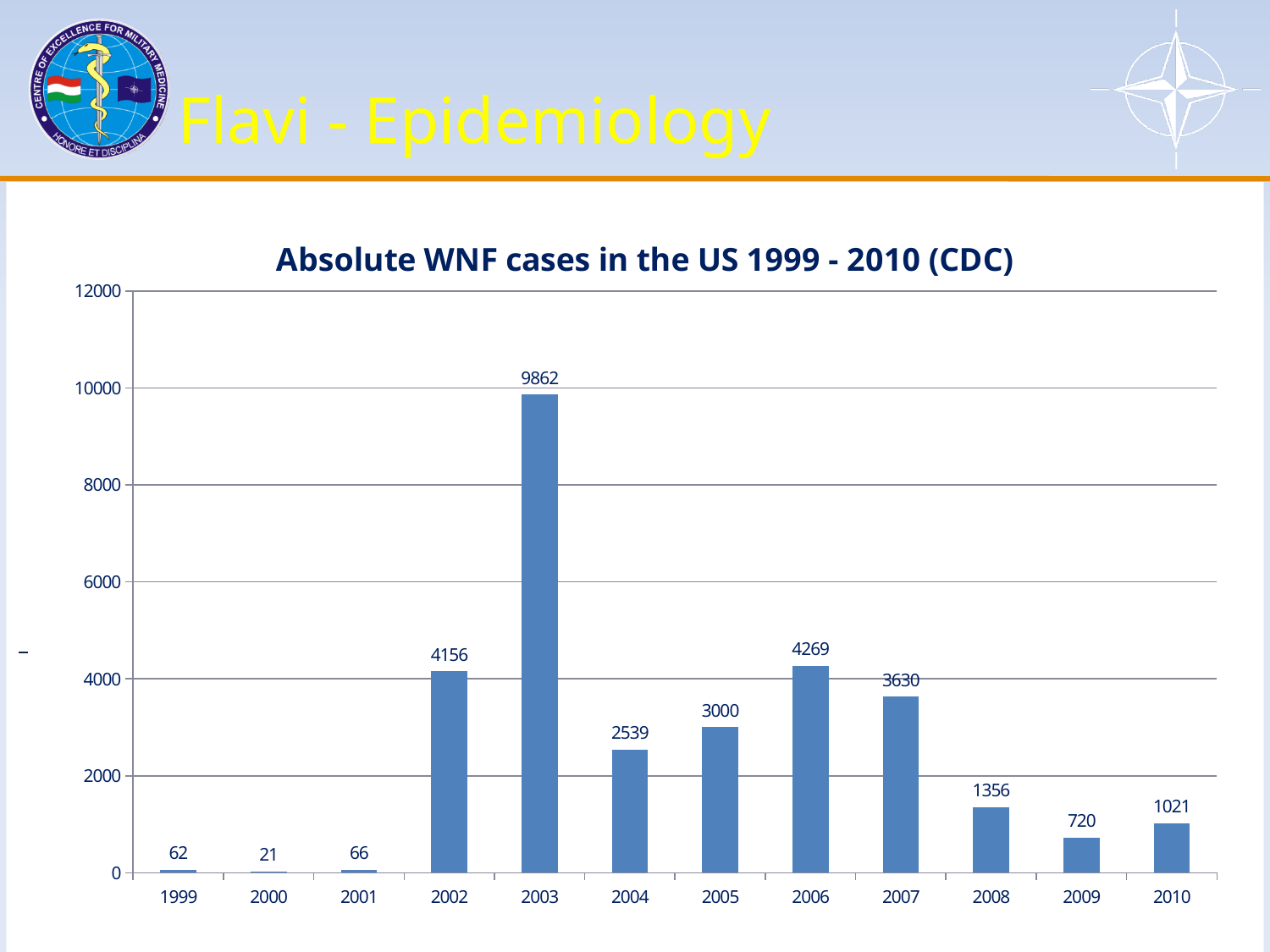
What kind of chart is shown on the slide? Bar chart Which year has the highest number of WNF cases? 2003 What is the difference in WNF cases between 2006 and 2005? 1269 What is the title of the chart? Absolute WNF cases in the US 1999 - 2010 (CDC) What is the number of WNF cases in 2000? 21 Is the value for 2008 greater or less than 2000? less What is the number of WNF cases in 2003? 9862 What is the difference in WNF cases between 2003 and 2002? 5706 Which year had more WNF cases, 2004 or 2007? 2007 How many years are shown on the x axis? 12 Which year has the lowest number of WNF cases? 2000 What is the number of WNF cases in 2007? 3630